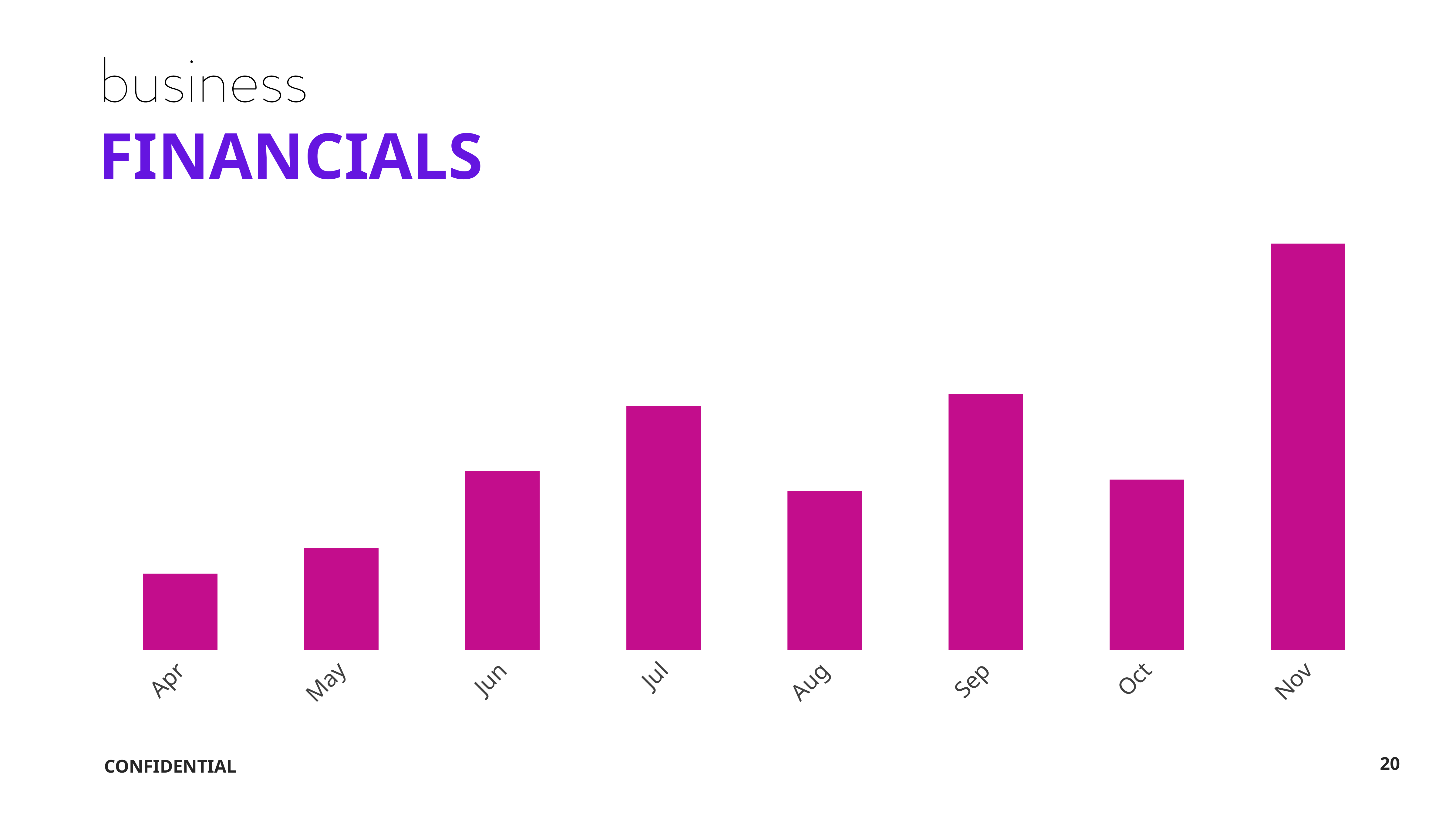
Which is larger, the value for May or the value for Jun? Jun Which is larger, the value for Nov or the value for Sep? Nov What kind of chart is shown on the slide? bar chart What colour are the bars in the chart? magenta Which is larger, the value for Jul or the value for Aug? Jul Does the value rise or fall from Jul to Aug? fall Do the values rise or fall from Apr to Jul? rise Which month has the lowest bar in the chart? Apr Which month has the highest bar in the chart? Nov How many months are shown on the x axis of the chart? 8